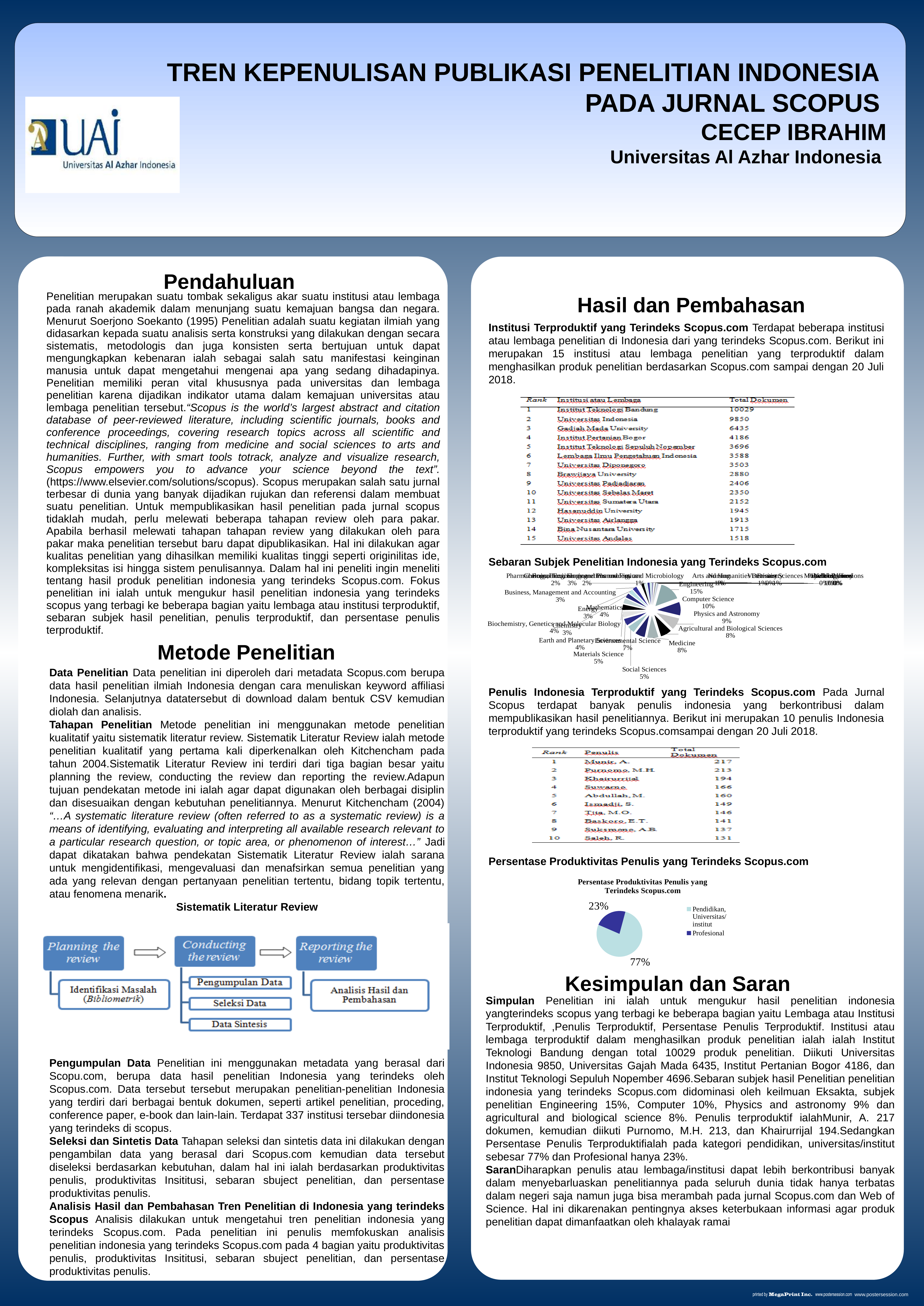
In the 'Sebaran Subjek Penelitian Indonesia yang Terindeks Scopus.com' chart, what share is Engineering? 15% In the 'Sebaran Subjek Penelitian Indonesia yang Terindeks Scopus.com' chart, which is larger, Medicine or Social Sciences? Medicine In the 'Persentase Produktivitas Penulis yang Terindeks Scopus.com' chart, what share is Pendidikan, Universitas/institut? 77% In the 'Sebaran Subjek Penelitian Indonesia yang Terindeks Scopus.com' chart, what share is Physics and Astronomy? 9% What kind of chart is the 'Sebaran Subjek Penelitian Indonesia yang Terindeks Scopus.com' chart? pie chart In the 'Persentase Produktivitas Penulis yang Terindeks Scopus.com' chart, which category has the largest slice? Pendidikan, Universitas/institut What kind of chart is the 'Persentase Produktivitas Penulis yang Terindeks Scopus.com' chart? pie chart How many categories does the legend of the 'Persentase Produktivitas Penulis yang Terindeks Scopus.com' chart list? 2 In the 'Sebaran Subjek Penelitian Indonesia yang Terindeks Scopus.com' chart, what is the difference between the Engineering share and the Environmental Science share? 8% In the 'Persentase Produktivitas Penulis yang Terindeks Scopus.com' chart, what is the difference between the Pendidikan, Universitas/institut share and the Profesional share? 54%